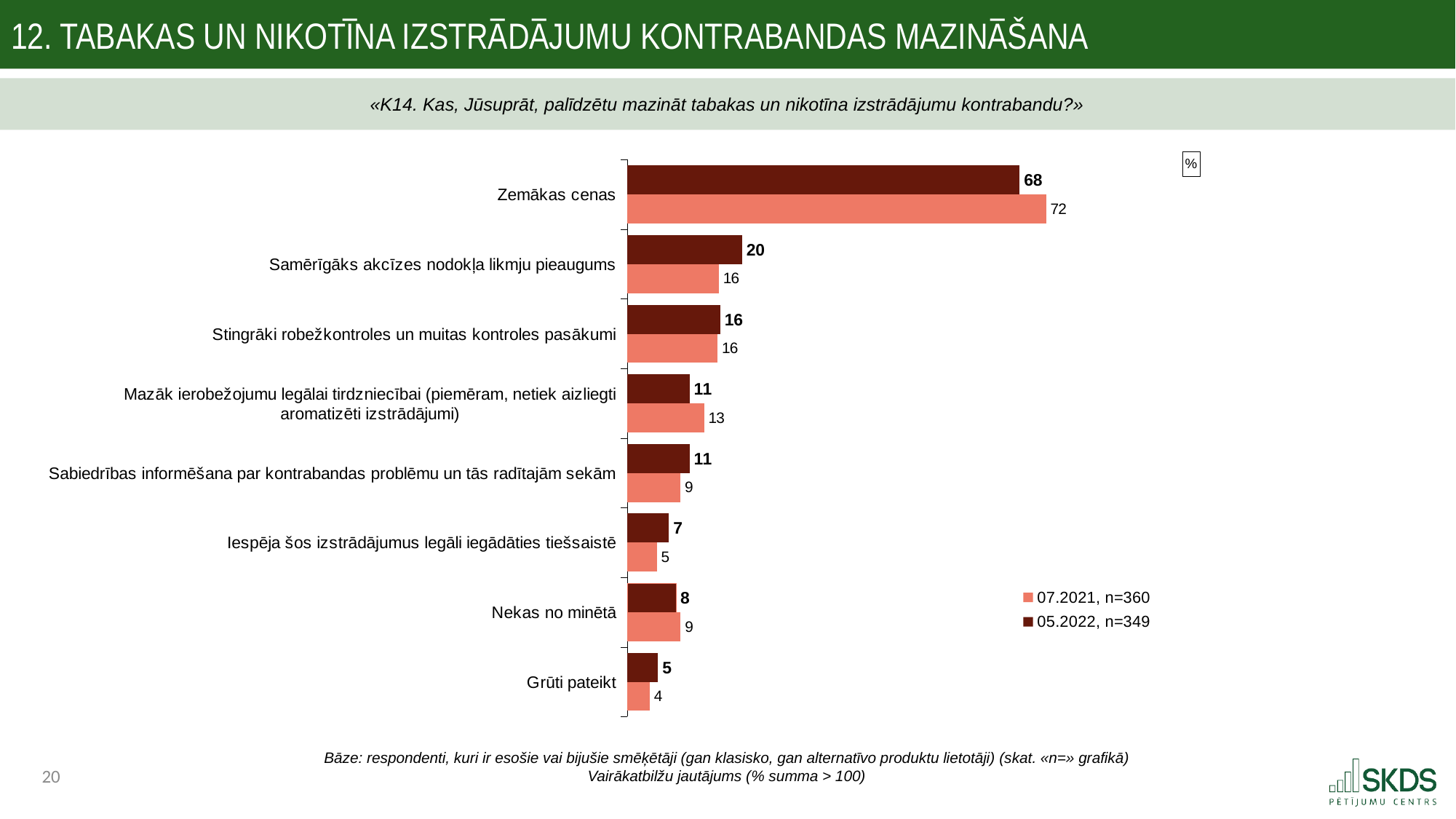
What colour are the bars for the 05.2022, n=349 series? Dark red Which category has the highest value in the 05.2022, n=349 series? Zemākas cenas For "Samērīgāks akcīzes nodokļa likmju pieaugums", which series has the larger value: 07.2021, n=360 or 05.2022, n=349? 05.2022, n=349 What is the value for "Zemākas cenas" in the 07.2021, n=360 series? 72 What is the value for "Grūti pateikt" in the 05.2022, n=349 series? 5 How many series does the legend list? 2 How many categories are shown in the chart? 8 What is the value for "Zemākas cenas" in the 05.2022, n=349 series? 68 Which category has the lowest value in the 07.2021, n=360 series? Grūti pateikt What is the difference between the 07.2021 and 05.2022 values for "Zemākas cenas"? 4 What is the value for "Samērīgāks akcīzes nodokļa likmju pieaugums" in the 07.2021, n=360 series? 16 What kind of chart is shown on the slide? Bar chart